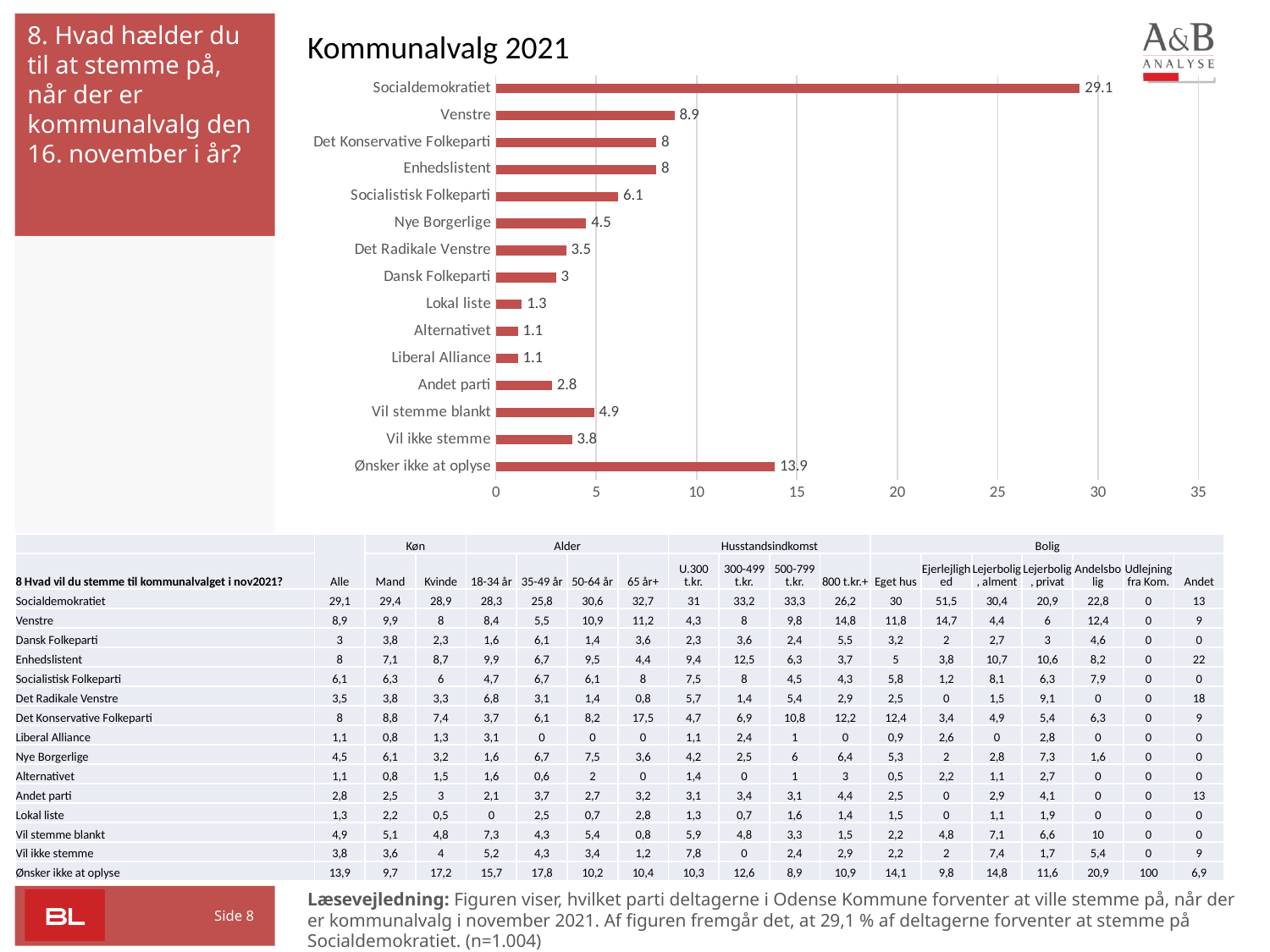
What is the value for Venstre in the chart? 8.9 What is the value for Nye Borgerlige in the chart? 4.5 What type of chart is shown on the slide? bar chart Is the value for Ønsker ikke at oplyse greater or less than 10? greater How many categories are shown in the chart? 15 Which category has the highest value in the chart? Socialdemokratiet What is the title of the chart? Kommunalvalg 2021 What is the difference between the values for Venstre and Socialistisk Folkeparti? 2.8 Which has a larger value, Vil stemme blankt or Vil ikke stemme? Vil stemme blankt What is the difference between the values for Socialdemokratiet and Ønsker ikke at oplyse? 15.2 What is the value for Socialdemokratiet in the chart? 29.1 What is the value for Ønsker ikke at oplyse in the chart? 13.9